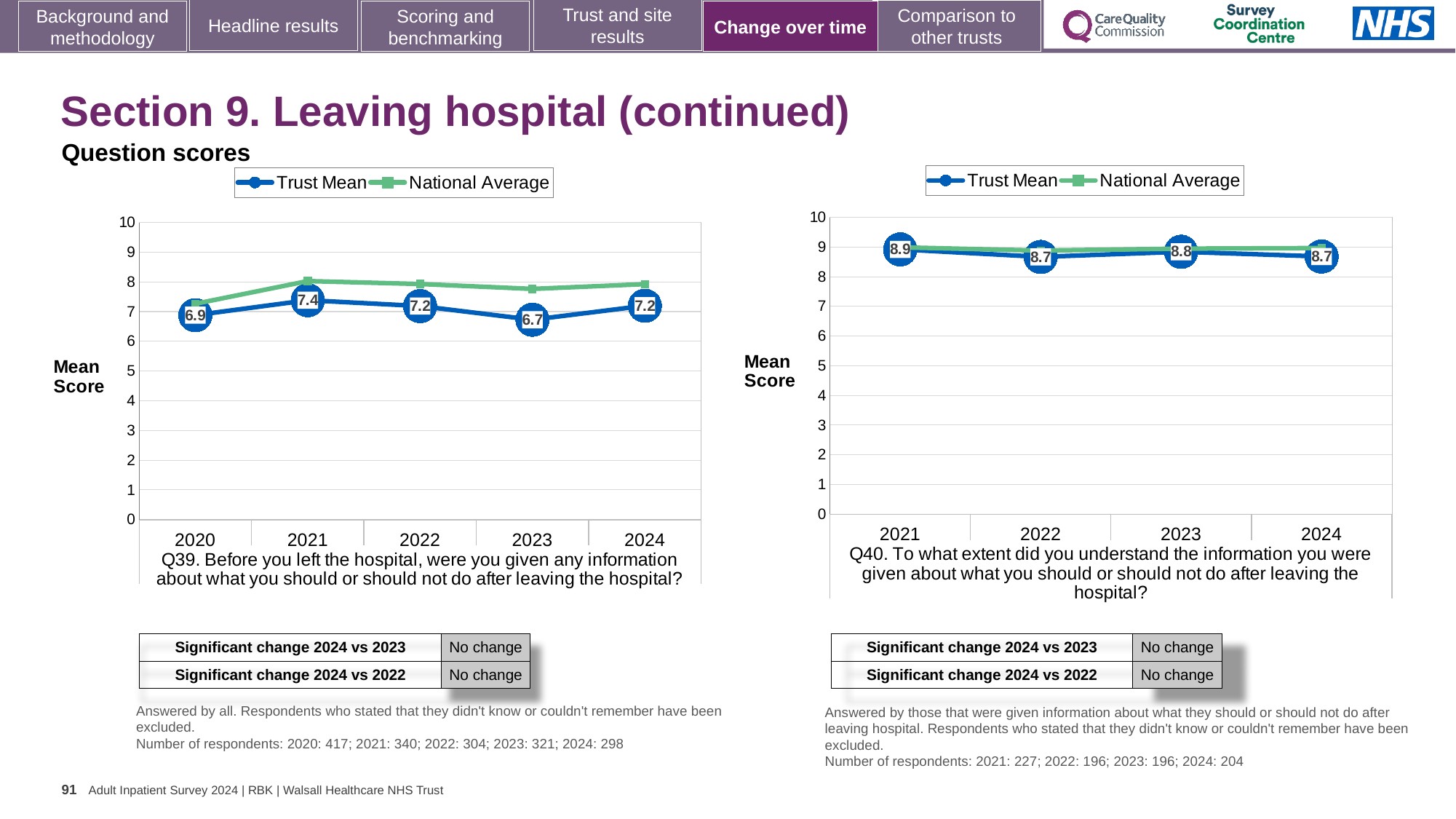
In the Q40 chart (right), which is larger, the Trust Mean for 2021 or for 2022? 2021 How many series does the legend of the Q39 chart (left) list? 2 In the Q39 chart (left), what is the Trust Mean score for 2021? 7.4 How many years are plotted on the x axis of the Q40 chart (right)? 4 In the Q39 chart (left), what is the difference between the Trust Mean scores for 2021 and 2023? 0.7 In the Q39 chart (left), what is the Trust Mean score for 2023? 6.7 In the Q40 chart (right), what is the Trust Mean score for 2021? 8.9 In the Q39 chart (left), is the National Average for 2021 greater or less than 7? greater In the Q39 chart (left), which year has the highest Trust Mean score? 2021 In the Q39 chart (left), which year has the lowest Trust Mean score? 2023 In the Q40 chart (right), what is the Trust Mean score for 2024? 8.7 What type of chart is used for the Q39 chart (left)? Line chart